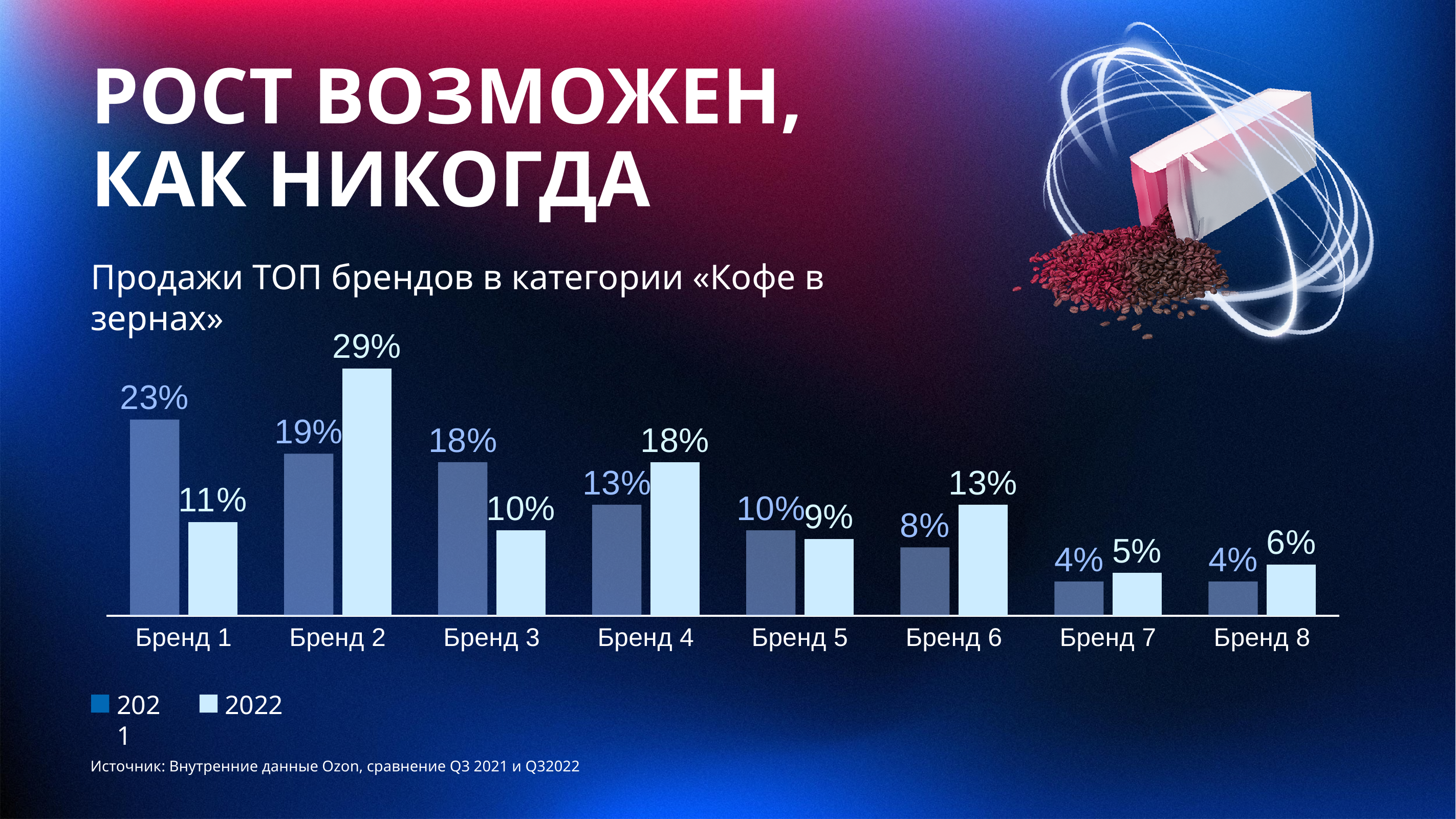
Which brand has the highest 2022 value? Бренд 2 What is the 2021 value for Бренд 5? 10% What is the difference between the 2021 and 2022 values for Бренд 1? 12% What is the 2022 value for Бренд 2? 29% How many series does the legend list? 2 What is the 2022 value for Бренд 6? 13% Which brand has the lowest 2022 value? Бренд 7 How many brands are shown on the x axis? 8 What kind of chart is shown on the slide? Bar chart What is the difference between the 2022 and 2021 values for Бренд 2? 10% Which is larger for Бренд 4: the 2021 value or the 2022 value? 2022 What is the 2021 value for Бренд 1? 23%